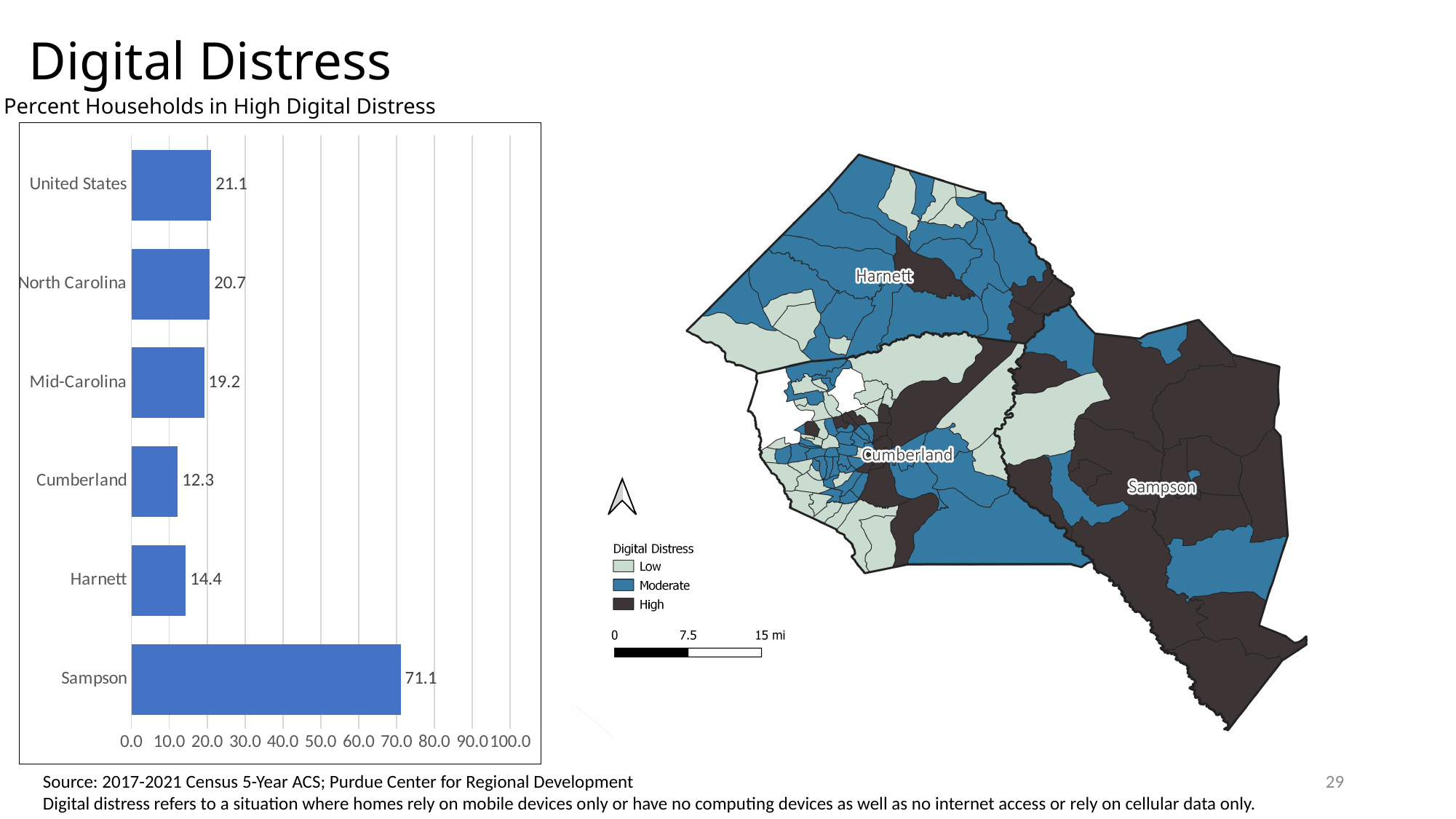
What is the value for Harnett in the Percent Households in High Digital Distress chart? 14.4 In the Percent Households in High Digital Distress chart, which is larger, the value for Harnett or the value for Cumberland? Harnett What is the maximum value shown on the x axis of the Percent Households in High Digital Distress chart? 100.0 What is the value for the United States in the Percent Households in High Digital Distress chart? 21.1 What is the value for Sampson in the Percent Households in High Digital Distress chart? 71.1 What is the value for Cumberland in the Percent Households in High Digital Distress chart? 12.3 How many categories are shown in the Percent Households in High Digital Distress chart? 6 What is the difference between the values for Sampson and Harnett in the Percent Households in High Digital Distress chart? 56.7 Which category has the highest value in the Percent Households in High Digital Distress chart? Sampson What is the difference between the values for North Carolina and Mid-Carolina in the Percent Households in High Digital Distress chart? 1.5 Which category has the lowest value in the Percent Households in High Digital Distress chart? Cumberland What kind of chart is the Percent Households in High Digital Distress chart? Bar chart